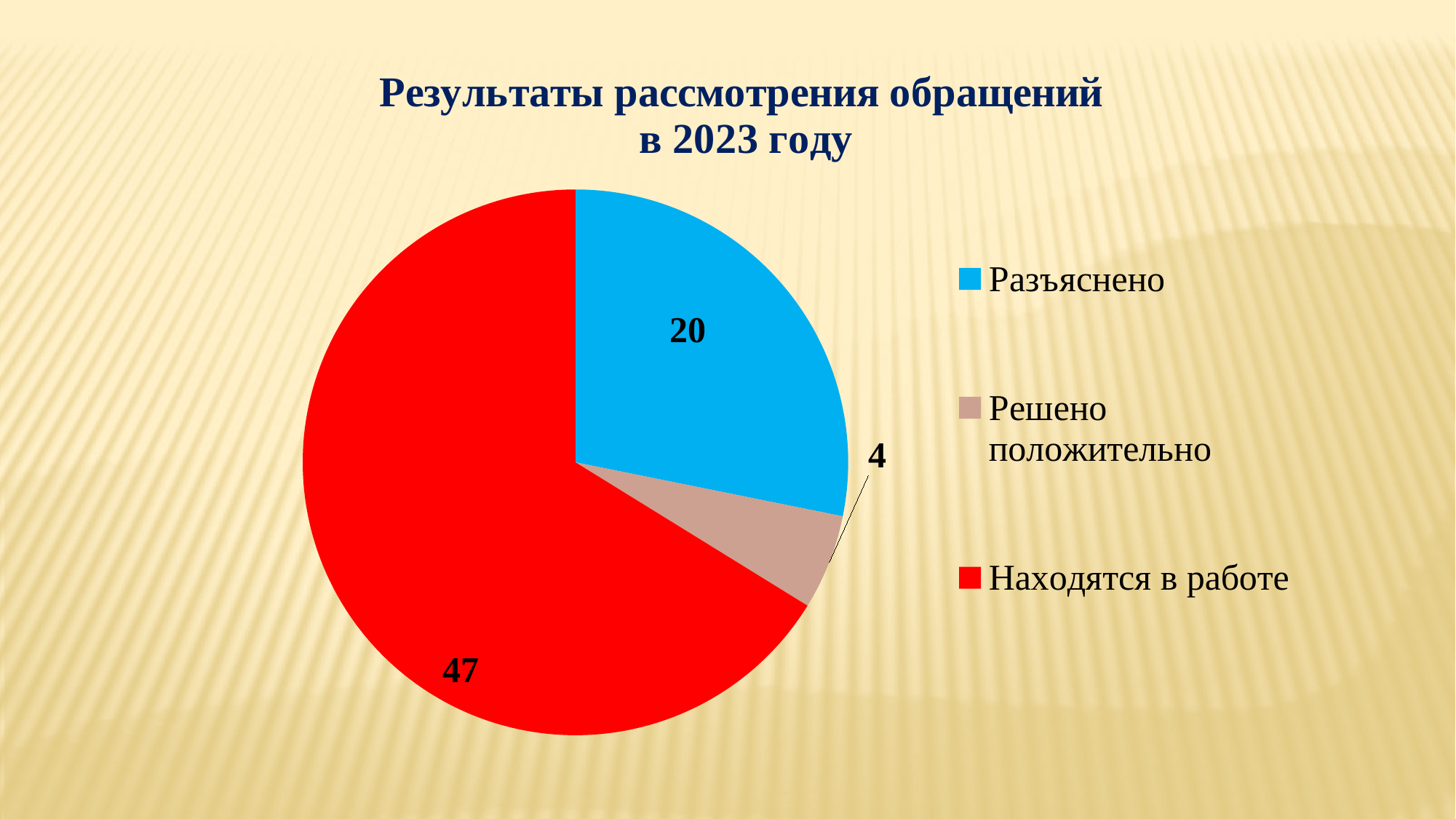
What is the value for Находятся в работе? 47 How many categories does the pie chart have? 3 Which category has the smallest slice of the pie? Решено положительно What is the title of the chart? Результаты рассмотрения обращений в 2023 году What type of chart is shown on the slide? Pie chart Which is larger, the value for Разъяснено or the value for Решено положительно? Разъяснено Which category has the largest slice of the pie? Находятся в работе What is the value for Решено положительно? 4 What is the difference between the values for Разъяснено and Решено положительно? 16 What is the value for Разъяснено? 20 What is the total of all slices in the pie chart? 71 What is the difference between the values for Находятся в работе and Разъяснено? 27